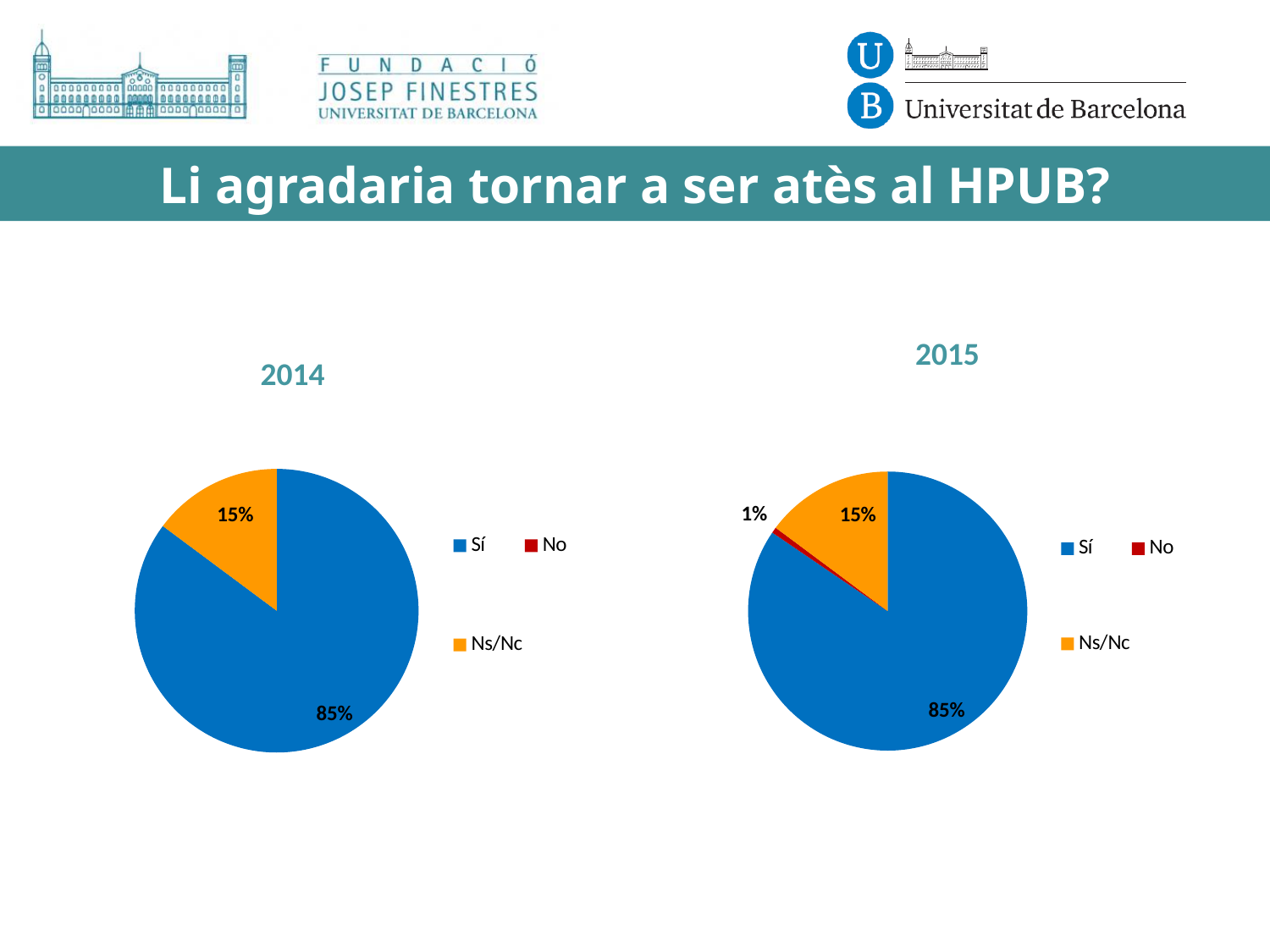
In the 2014 chart, what colour is the Sí slice? Blue In the 2015 chart, what share of responses is No? 1% In the 2014 chart, which category has the largest slice? Sí In the 2015 chart, what share of responses is Ns/Nc? 15% In the 2014 chart, what share of responses is Ns/Nc? 15% In the 2015 chart, which category has the smallest slice? No In the 2015 chart, what share of responses is Sí? 85% In the 2014 chart, what share of responses is Sí? 85% How many entries does the legend of the 2015 chart list? 3 In the 2015 chart, which is larger, the Ns/Nc slice or the No slice? Ns/Nc In the 2015 chart, what is the difference between the Sí and Ns/Nc shares? 70% What kind of chart is the 2014 chart? Pie chart